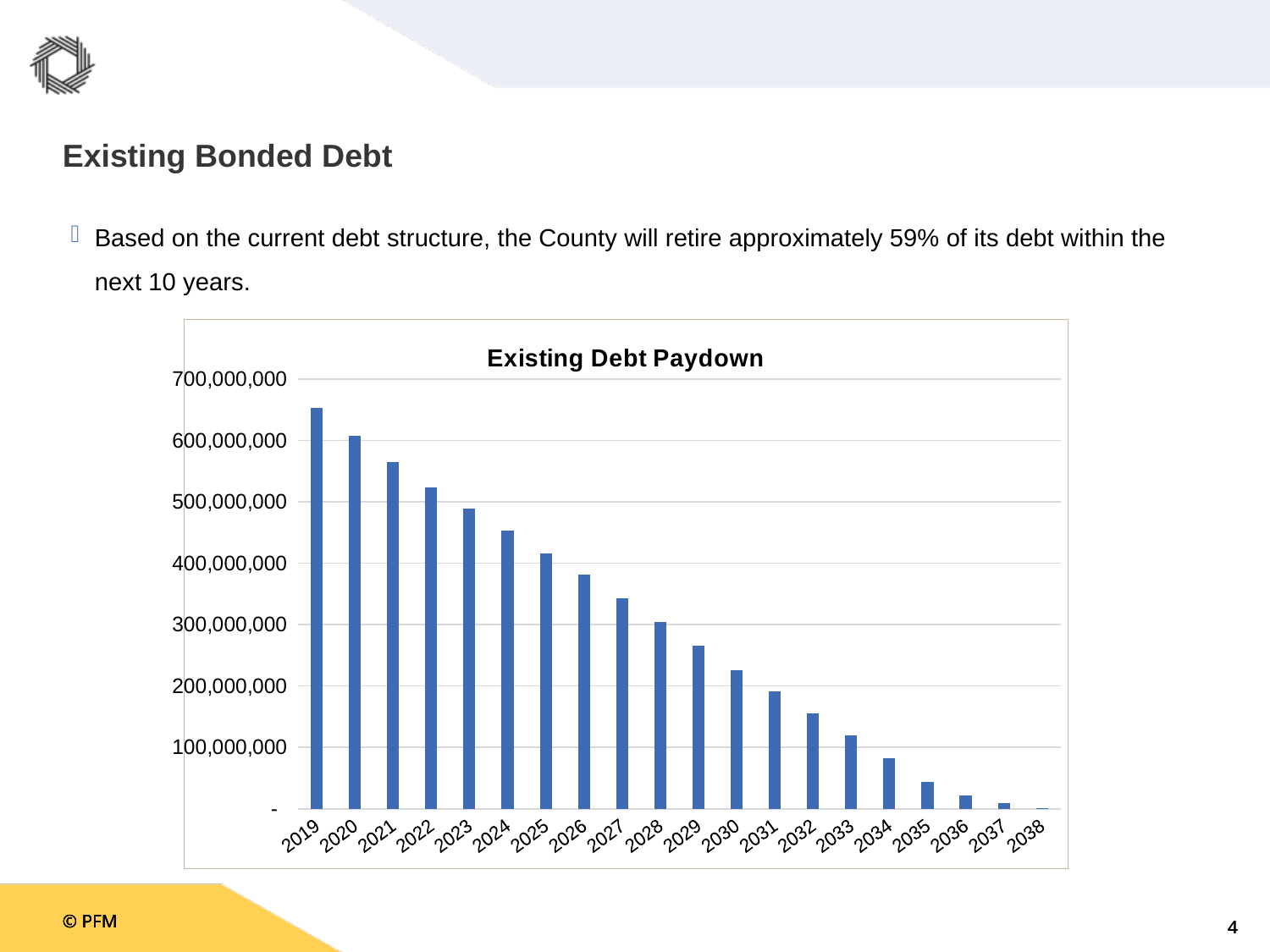
Which is larger, the value for 2021 or the value for 2030? 2021 Which year has the highest value in the chart? 2019 Which year has the lowest value in the chart? 2038 What is the title of the chart? Existing Debt Paydown Is the value for 2019 greater or less than 600,000,000? greater What kind of chart is shown on the slide? Bar chart What is the first year shown on the x axis of the chart? 2019 Is the value for 2027 greater or less than 300,000,000? greater Is the value for 2034 greater or less than 100,000,000? less Do the values rise or fall from 2019 to 2038? Fall How many years are shown on the x axis of the chart? 20